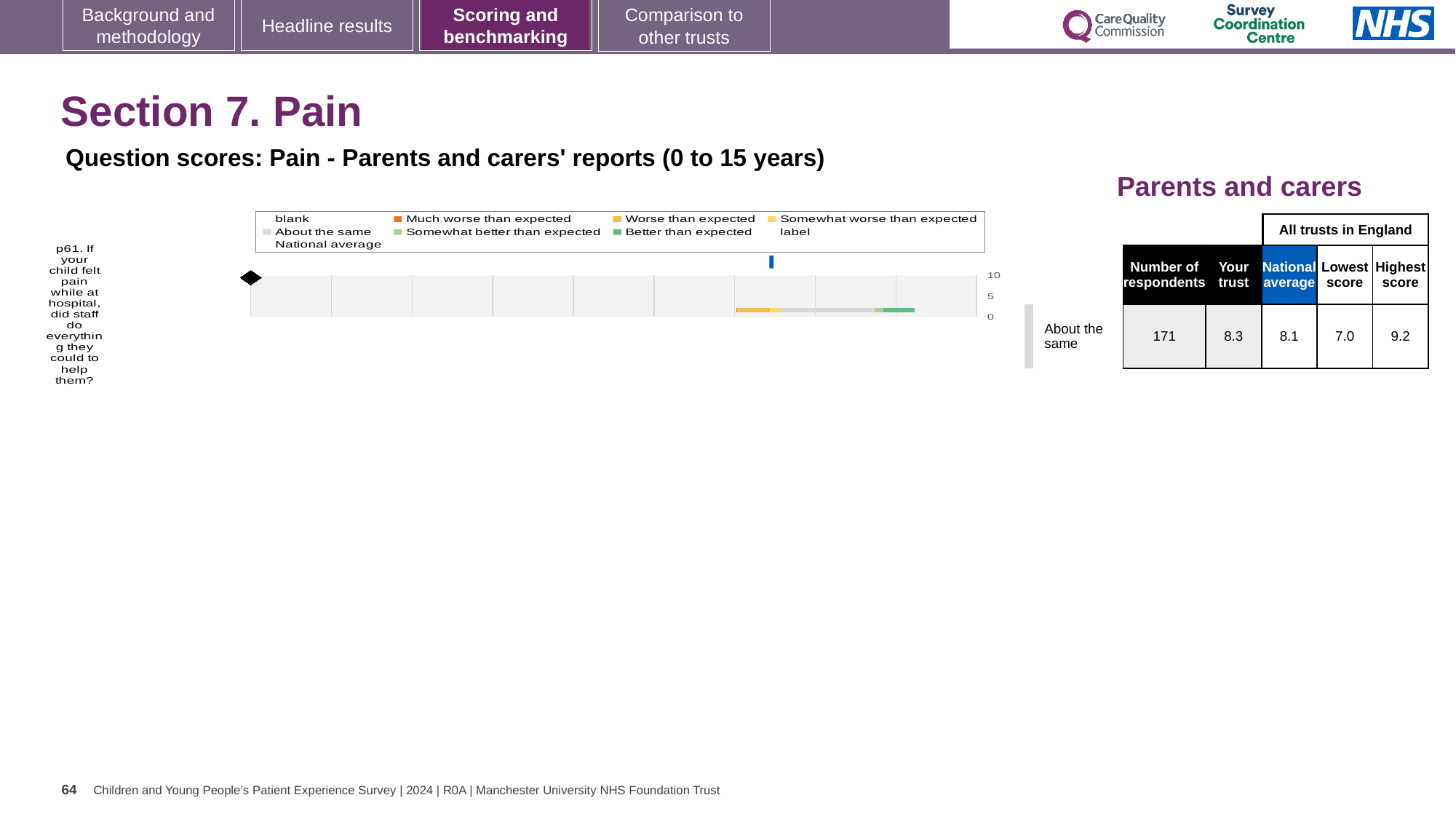
According to the table, what is the 'Your trust' score for question p61? 8.3 Which colour in the legend represents 'Better than expected'? green What is the maximum value shown on the chart's score axis? 10 Is the national average marker for question p61 plotted at a value greater or less than 5? greater According to the table, what is the national average score for question p61? 8.1 What is the difference between the highest and lowest trust scores for question p61? 2.2 What is the lowest score among all trusts in England for question p61? 7.0 How many survey questions are plotted in the chart? 1 How many respondents answered question p61? 171 What is the highest score among all trusts in England for question p61? 9.2 What kind of chart is shown on the slide for question p61? bar chart Which is larger for question p61: the 'Your trust' score or the national average? Your trust